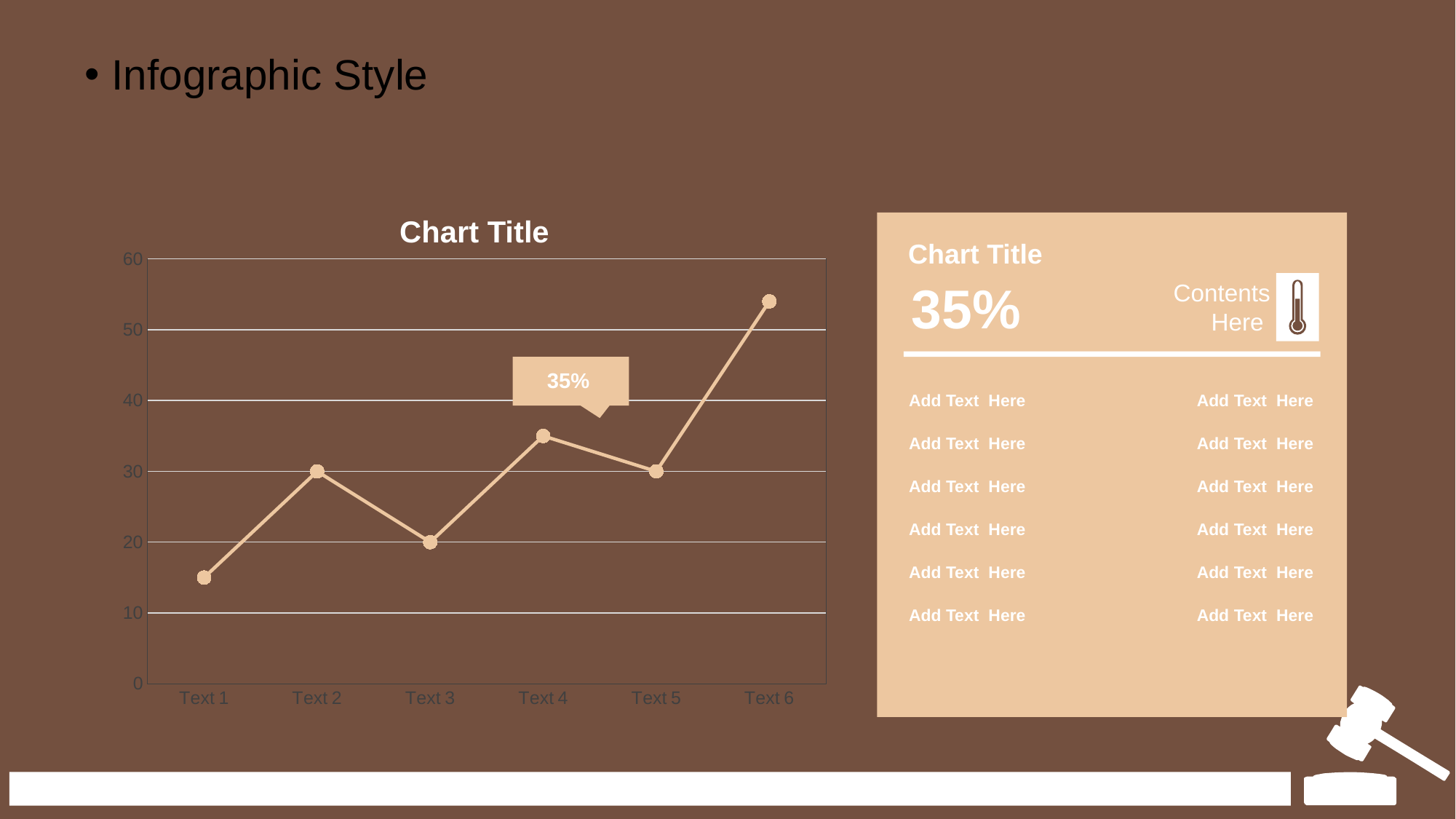
What value does the callout label above the Text 4 point show? 35% What is the difference between the values for Text 2 and Text 3? 10 Which is larger, the value for Text 2 or the value for Text 3? Text 2 What kind of chart is shown on the slide? line chart Which category has the lowest value on the line chart? Text 1 Is the value for Text 1 greater or less than 20? less What is the value for Text 2? 30 Is the value for Text 6 greater or less than 50? greater What is the value for Text 5? 30 Which category has the highest value on the line chart? Text 6 What is the value for Text 3? 20 How many data points are plotted on the line chart? 6